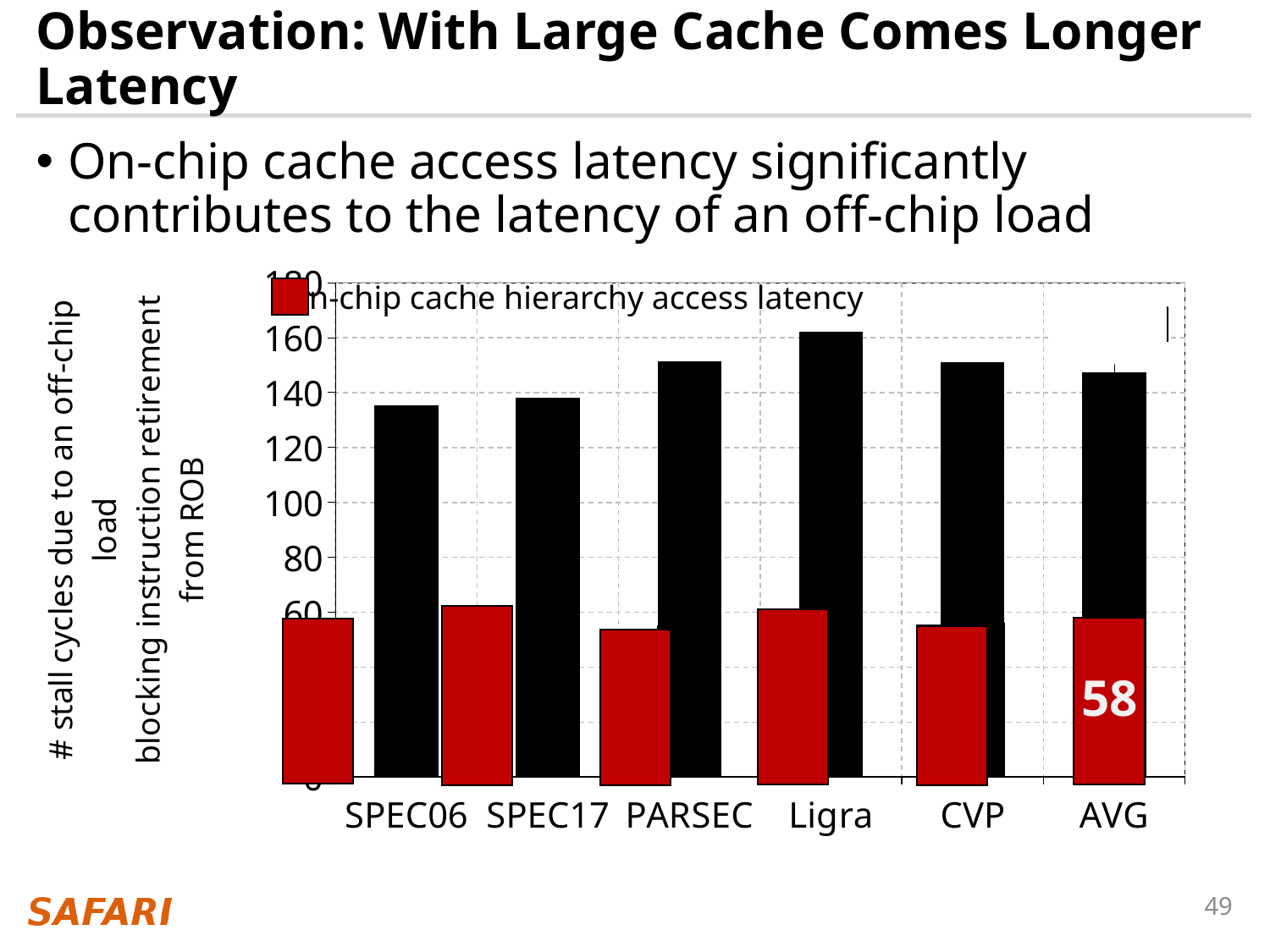
What value is labelled on the red bar for AVG? 58 How many categories are shown on the x axis? 6 What kind of chart is shown on the slide? bar chart Is the black bar for Ligra greater or less than 140? greater Is the red bar for PARSEC greater or less than 60? less What is the last category on the x axis? AVG What colour is the bar labelled 58? red Is the black bar for PARSEC greater or less than 140? greater Which has the taller black bar, Ligra or SPEC06? Ligra Which category has the tallest black bar? Ligra Which has the taller black bar, PARSEC or SPEC17? PARSEC